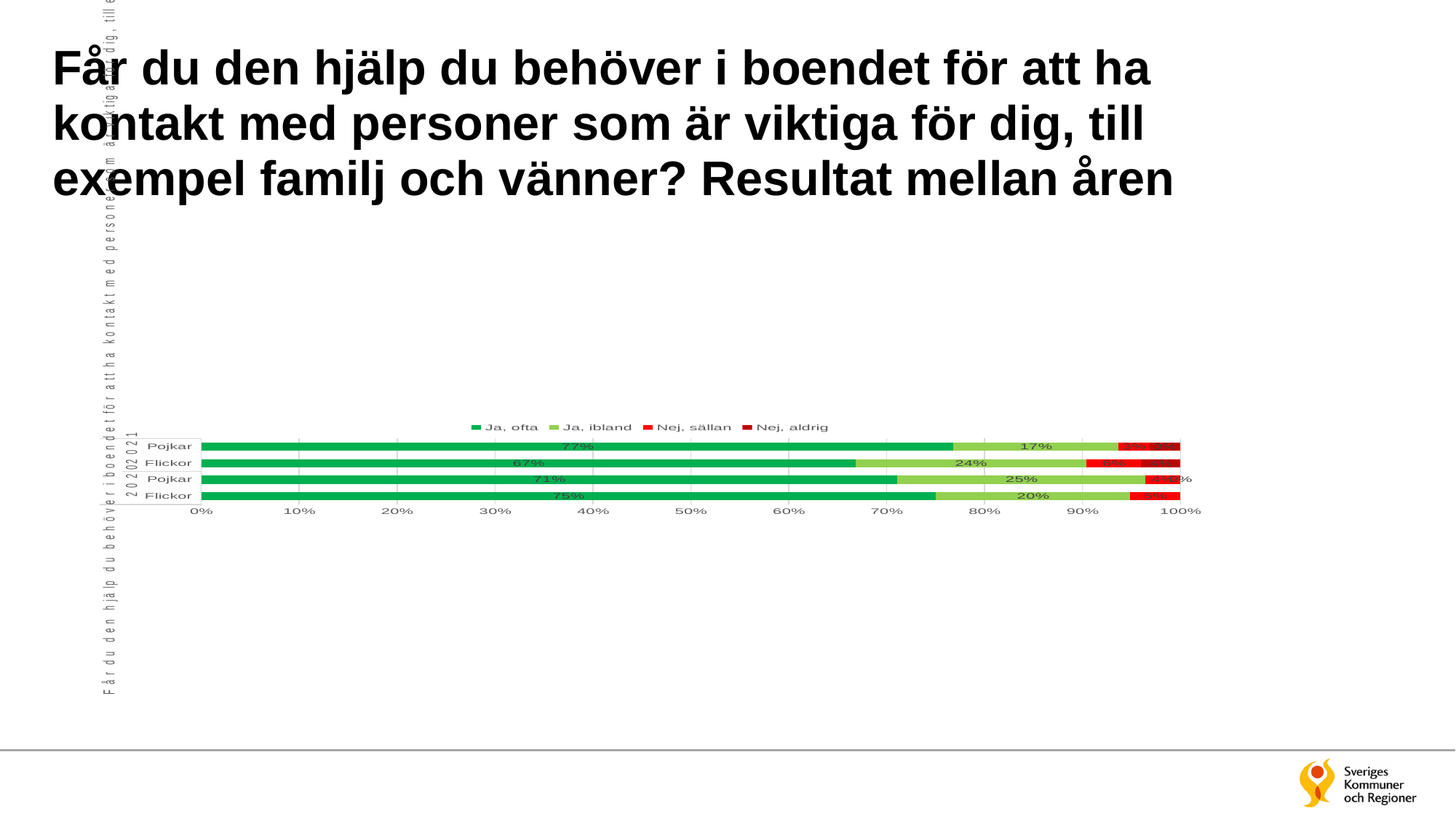
What are the four legend entries in the chart? Ja, ofta; Ja, ibland; Nej, sällan; Nej, aldrig What kind of chart is shown on the slide? Stacked bar chart What is the 'Ja, ofta' value for the topmost Pojkar bar? 77% What is the difference in 'Ja, ofta' between the topmost Pojkar bar (77%) and the upper Flickor bar (67%)? 10 percentage points Which bar has the highest 'Ja, ofta' share? The topmost Pojkar bar (77%) How many series does the chart legend list? 4 What is the 'Ja, ibland' value for the lower Pojkar bar (third from the top)? 25% How many bars are plotted in the chart? 4 What is the 'Ja, ofta' value for the upper Flickor bar (second from the top)? 67% What is the 'Ja, ibland' value for the upper Flickor bar (second from the top)? 24% Which is larger: the 'Ja, ibland' value for the topmost Pojkar bar or for the bottom Flickor bar? Bottom Flickor bar (20%) What is the 'Ja, ofta' value for the bottom Flickor bar? 75%